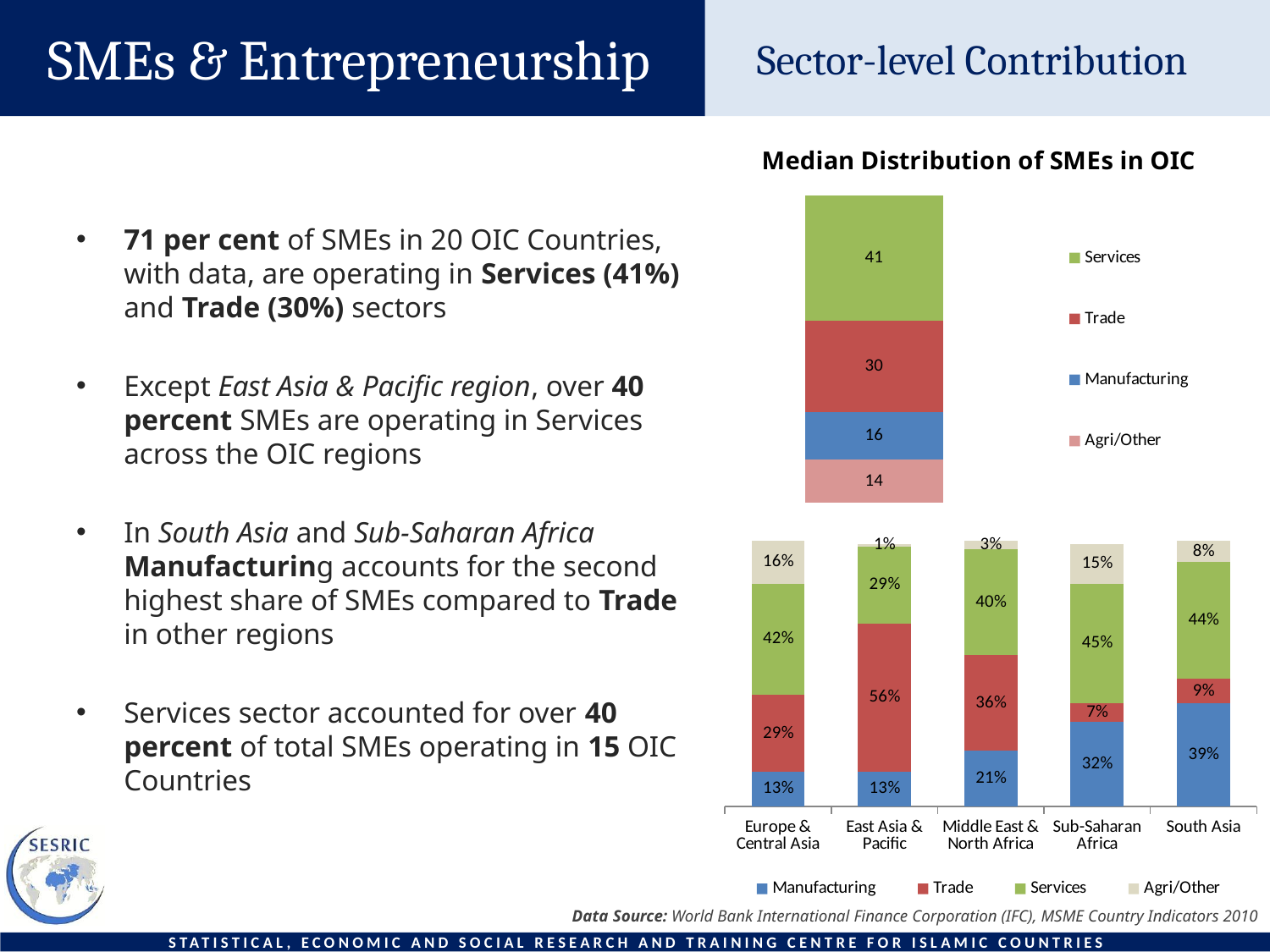
In the bottom chart showing regions, what is the Manufacturing share for South Asia? 39% In the bottom chart showing regions, how many regions are shown on the x axis? 5 In the top chart titled 'Median Distribution of SMEs in OIC', what is the difference between the Services and Trade values? 11 In the bottom chart showing regions, which region has the highest Services share? Sub-Saharan Africa In the top chart titled 'Median Distribution of SMEs in OIC', how many series does the legend list? 4 In the bottom chart showing regions, which is larger: the Manufacturing share for Sub-Saharan Africa or for Middle East & North Africa? Sub-Saharan Africa In the bottom chart showing regions, which region has the lowest Agri/Other share? East Asia & Pacific What type of chart is the bottom chart showing regions? Stacked bar chart In the top chart titled 'Median Distribution of SMEs in OIC', which sector has the lowest value? Agri/Other In the top chart titled 'Median Distribution of SMEs in OIC', what is the value for Agri/Other? 14 In the top chart titled 'Median Distribution of SMEs in OIC', what is the value for Services? 41 In the bottom chart showing regions, what is the Trade share for East Asia & Pacific? 56%